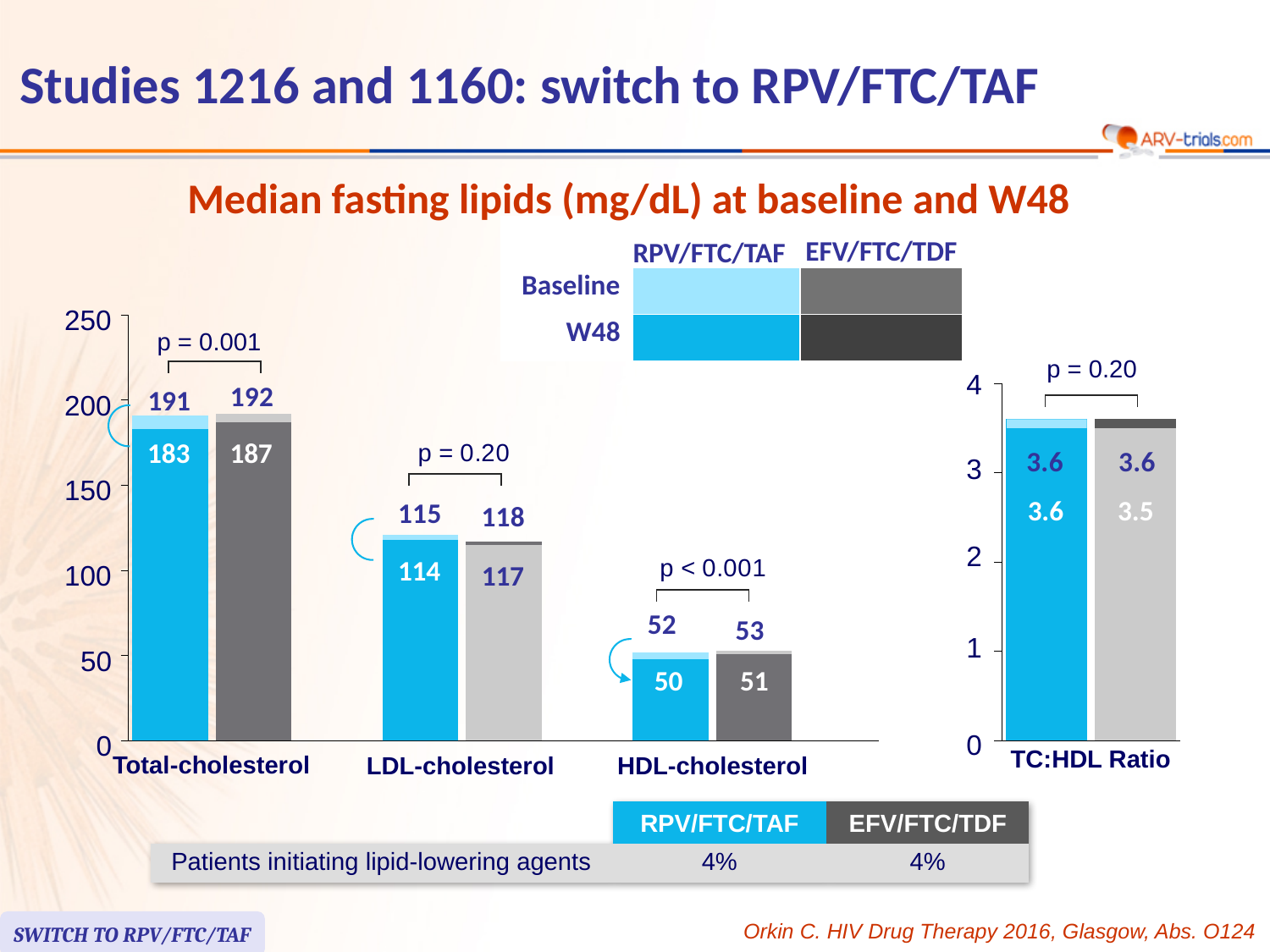
What type of chart is used to show the median fasting lipids? Bar chart In the left chart, what is the baseline median HDL-cholesterol value for the RPV/FTC/TAF group? 52 In the left chart, what is the difference between the baseline and W48 median total-cholesterol values for the RPV/FTC/TAF group? 8 In the left chart, what is the W48 median LDL-cholesterol value for the EFV/FTC/TDF group? 117 In the right chart (TC:HDL Ratio), what is the W48 value for the EFV/FTC/TDF group? 3.5 In the left chart, what is the W48 median total-cholesterol value for the RPV/FTC/TAF group? 183 How many lipid categories are shown on the x axis of the left chart? 3 In the left chart, what is the difference between the W48 median total-cholesterol values of the EFV/FTC/TDF and RPV/FTC/TAF groups? 4 How many treatment groups does the legend list? 2 In the left chart, which lipid category has the lowest values? HDL-cholesterol In the left chart, which group has the higher W48 median HDL-cholesterol value, RPV/FTC/TAF or EFV/FTC/TDF? EFV/FTC/TDF In the left chart, what is the baseline median total-cholesterol value for the EFV/FTC/TDF group? 192